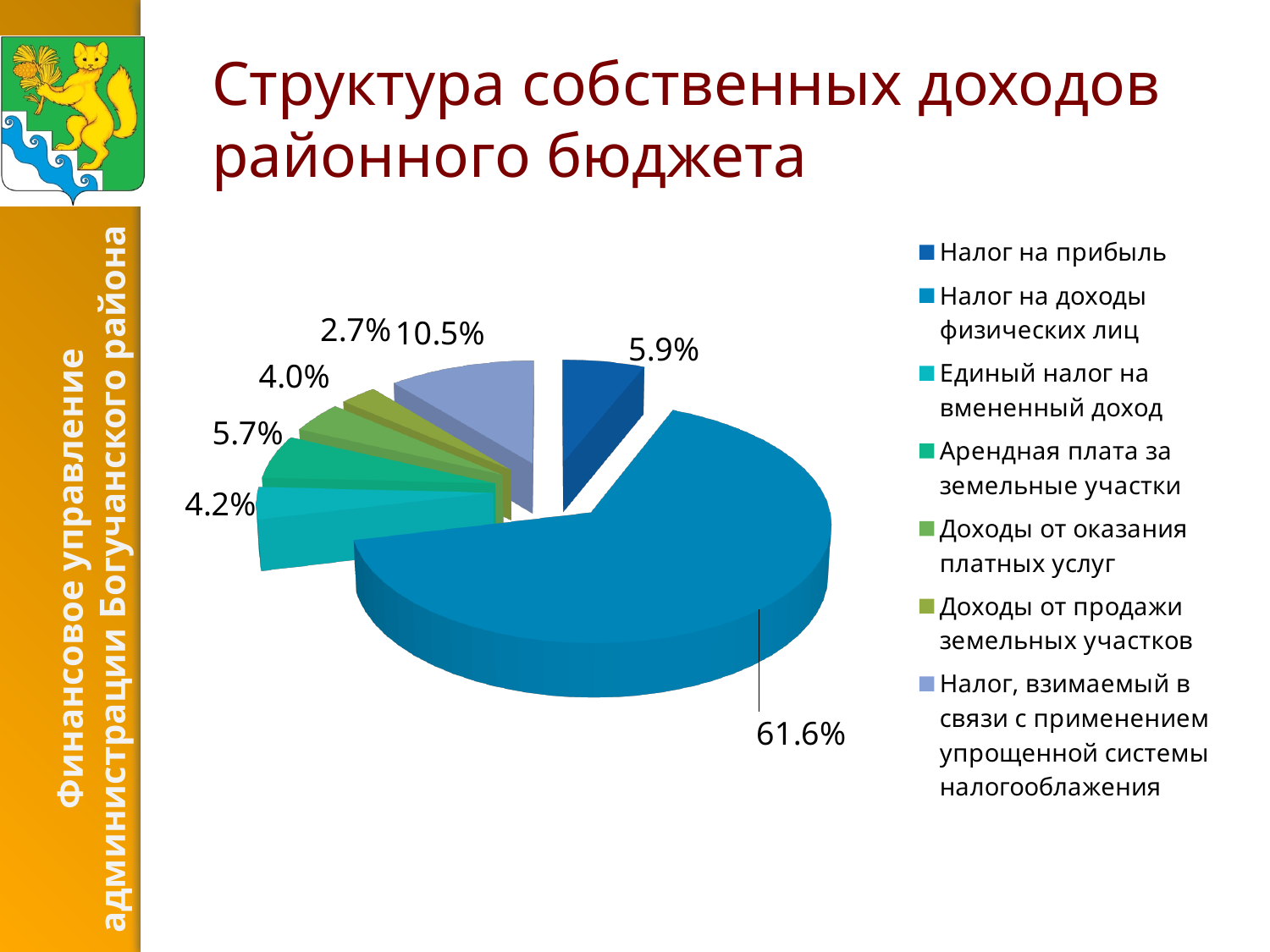
What share of the pie does "Арендная плата за земельные участки" have? 5.7% Which is larger: the share of "Единый налог на вмененный доход" or the share of "Арендная плата за земельные участки"? Арендная плата за земельные участки How many slices does the pie chart have? 7 What share of the pie does "Налог, взимаемый в связи с применением упрощенной системы налогооблажения" have? 10.5% What share of the pie does "Налог на доходы физических лиц" have? 61.6% Which category has the largest share of the pie? Налог на доходы физических лиц What share of the pie does "Налог на прибыль" have? 5.9% Which category has the smallest share of the pie? Доходы от продажи земельных участков What kind of chart is shown on the slide? pie chart What is the title of the slide containing the chart? Структура собственных доходов районного бюджета What share of the pie does "Доходы от продажи земельных участков" have? 2.7% What is the difference between the shares of "Налог на доходы физических лиц" and "Налог, взимаемый в связи с применением упрощенной системы налогооблажения"? 51.1%